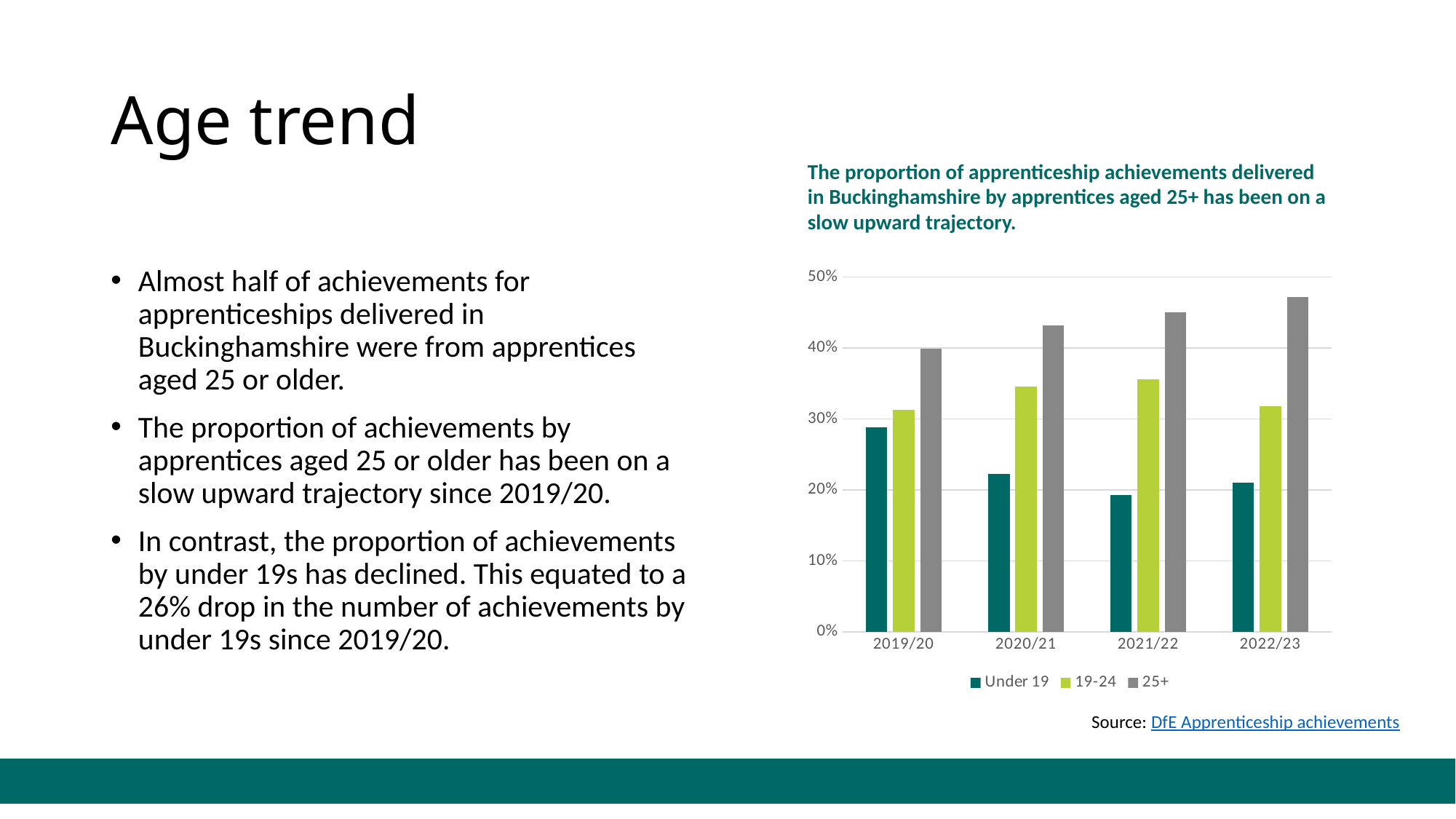
In which year is the 25+ series at its highest? 2022/23 In which year is the Under 19 series at its lowest? 2021/22 Which age group has the highest proportion in 2022/23? 25+ Is the value for Under 19 in 2020/21 greater or less than 20%? greater How many academic years are shown on the x axis of the chart? 4 In 2022/23, which is larger: the value for 19-24 or the value for Under 19? 19-24 What kind of chart is shown on the slide? Bar chart Does the proportion for the 25+ group rise or fall from 2019/20 to 2022/23? Rise Which colour represents the Under 19 series in the chart? Dark teal Is the value for 19-24 in 2021/22 greater or less than 30%? greater Is the value for 25+ in 2022/23 greater or less than 40%? greater How many series does the chart legend list? 3